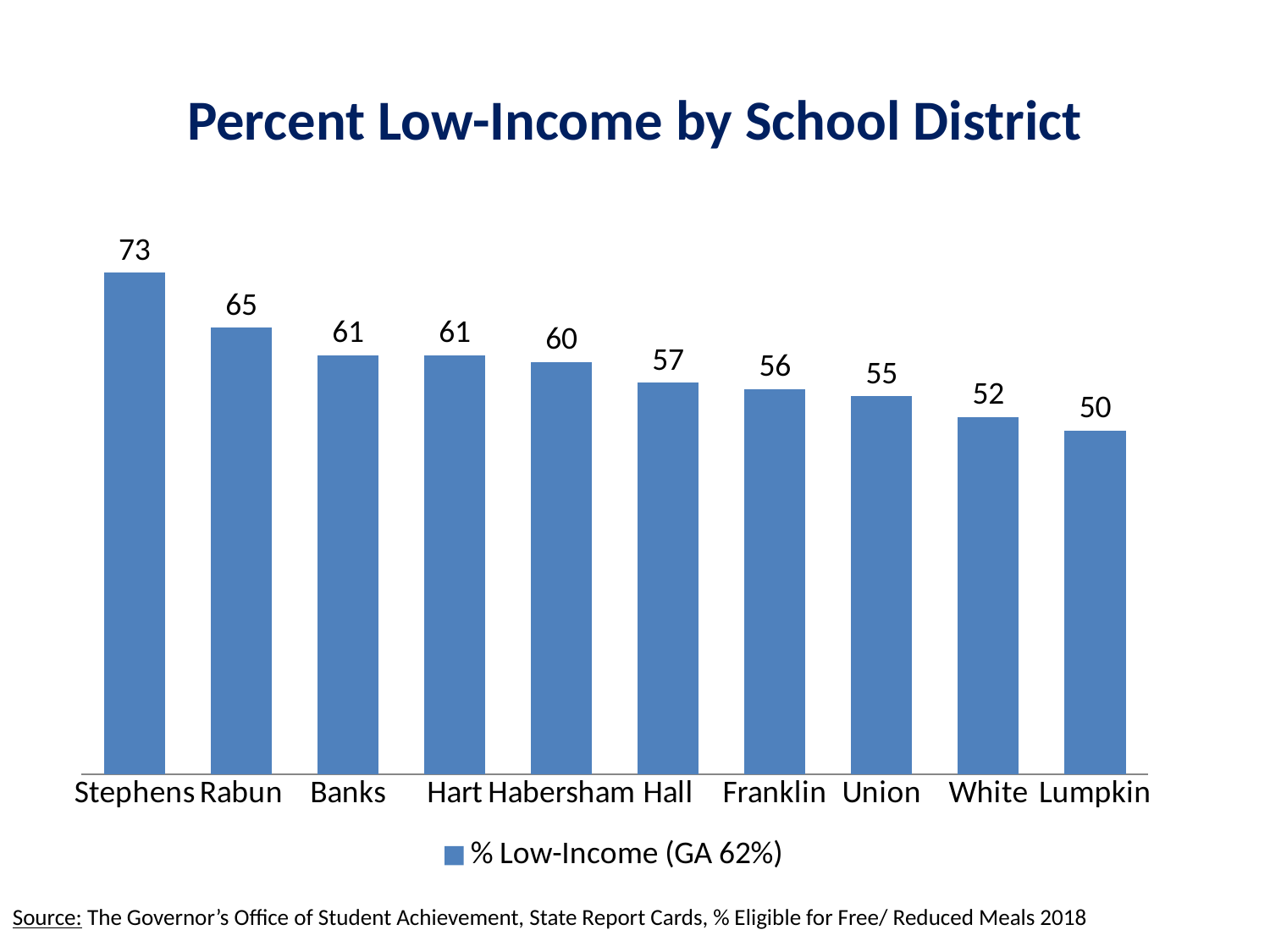
Which school district has the highest percent low-income? Stephens What kind of chart is shown on the slide? Bar chart How many series does the legend list? 1 Which has a higher percent low-income, Rabun or White? Rabun What is the difference between the percent low-income for Rabun and Hall? 8 What is the percent low-income for Union? 55 What is the legend entry for the series in the chart? % Low-Income (GA 62%) What is the percent low-income for Habersham? 60 What is the difference between the percent low-income for Stephens and Lumpkin? 23 Which school district has the lowest percent low-income? Lumpkin What is the percent low-income for Stephens? 73 How many school districts are shown in the chart? 10